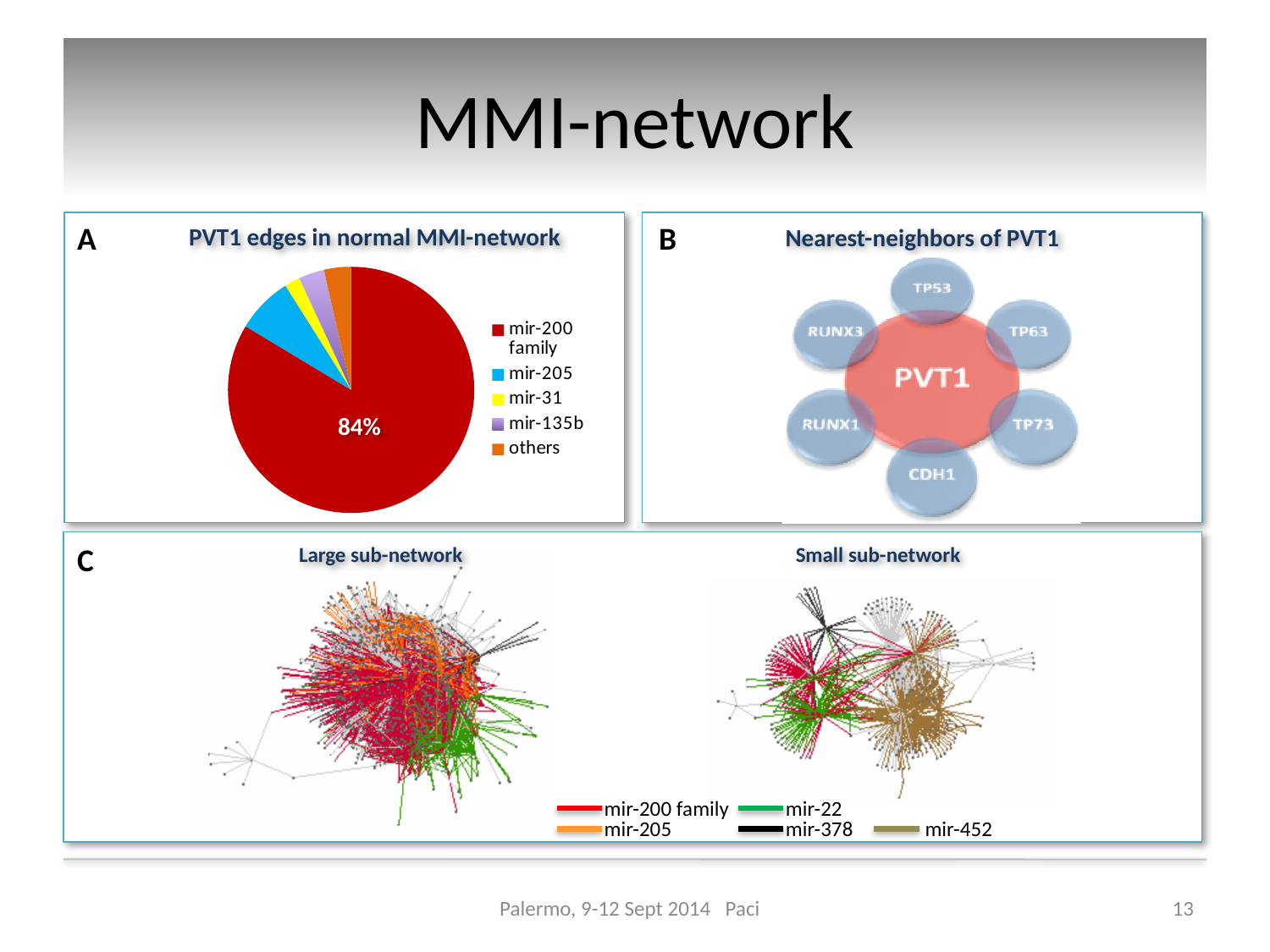
In the pie chart 'PVT1 edges in normal MMI-network', which slice is larger: mir-200 family or mir-205? mir-200 family In the pie chart 'PVT1 edges in normal MMI-network', which slice is larger: mir-205 or mir-31? mir-205 How many categories does the legend of the pie chart 'PVT1 edges in normal MMI-network' list? 5 How many slices does the pie chart 'PVT1 edges in normal MMI-network' have? 5 In the pie chart 'PVT1 edges in normal MMI-network', what colour is the mir-200 family slice? red In the pie chart 'PVT1 edges in normal MMI-network', is the share of the mir-200 family greater or less than 50%? greater What share of the pie chart 'PVT1 edges in normal MMI-network' does the mir-200 family account for? 84% What kind of chart is shown in panel A, 'PVT1 edges in normal MMI-network'? pie chart In the pie chart 'PVT1 edges in normal MMI-network', which category has the largest slice? mir-200 family In the pie chart 'PVT1 edges in normal MMI-network', what percentage is labelled for the mir-200 family slice? 84% What is the title of the pie chart in panel A? PVT1 edges in normal MMI-network